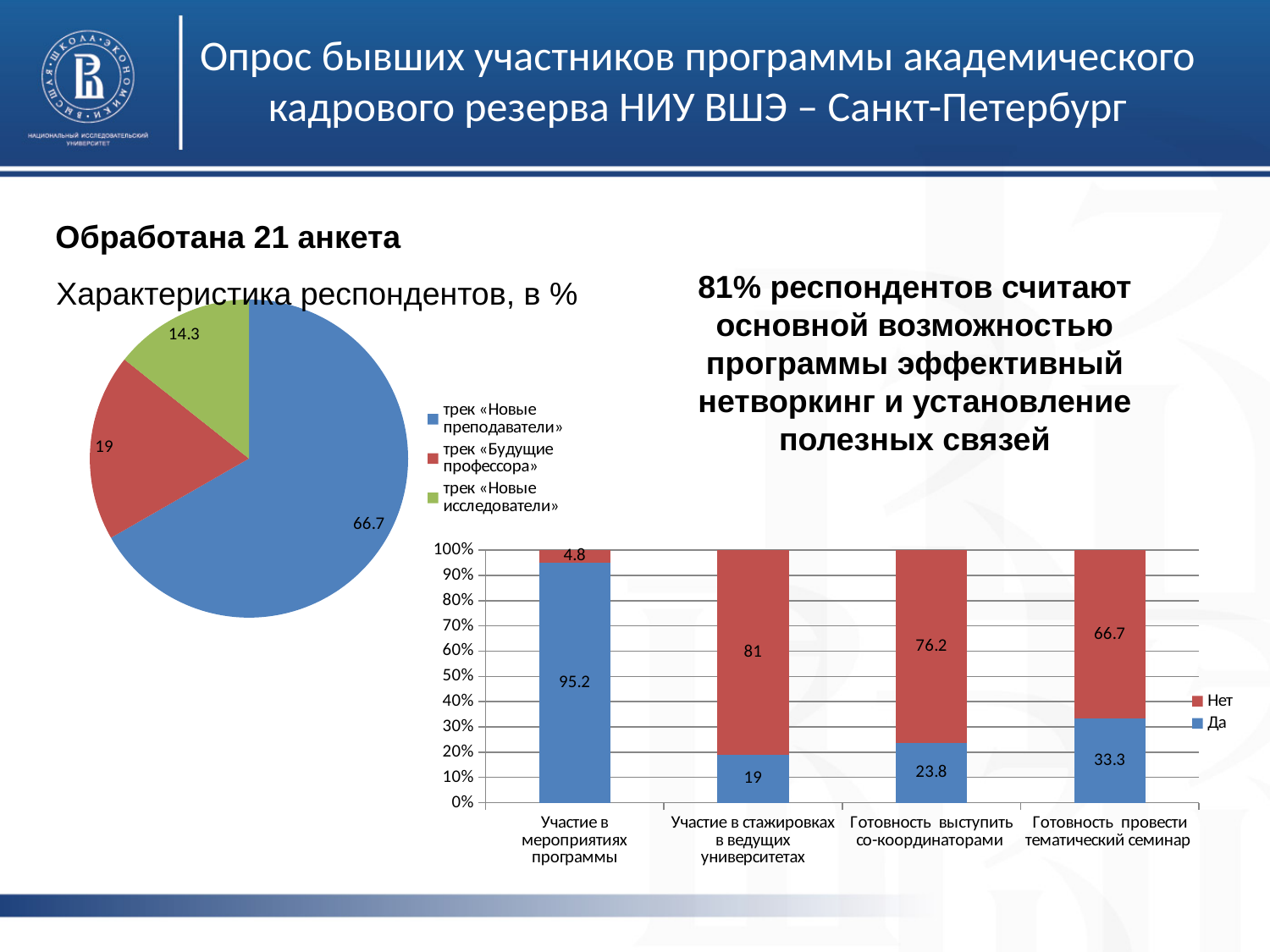
In the stacked bar chart at the bottom right, what is the 'Нет' value for 'Готовность выступить со-координаторами'? 76.2 In the stacked bar chart at the bottom right, what is the 'Да' value for 'Участие в мероприятиях программы'? 95.2 In the pie chart 'Характеристика респондентов, в %', what is the difference between the values for трек «Будущие профессора» and трек «Новые исследователи»? 4.7 In the stacked bar chart at the bottom right, which category has the lowest 'Да' value? Участие в стажировках в ведущих университетах In the stacked bar chart at the bottom right, which category has the highest 'Да' value? Участие в мероприятиях программы In the stacked bar chart at the bottom right, how many categories are shown on the x axis? 4 In the pie chart 'Характеристика респондентов, в %', which track has the smallest share? трек «Новые исследователи» What type of chart is the chart at the bottom right of the slide? Stacked bar chart In the pie chart 'Характеристика респондентов, в %', what is the value for трек «Новые преподаватели»? 66.7 In the pie chart 'Характеристика респондентов, в %', how many slices are there? 3 In the stacked bar chart at the bottom right, how many series does the legend list? 2 In the stacked bar chart at the bottom right, is the 'Да' value for 'Готовность провести тематический семинар' larger or the 'Да' value for 'Готовность выступить со-координаторами'? Готовность провести тематический семинар